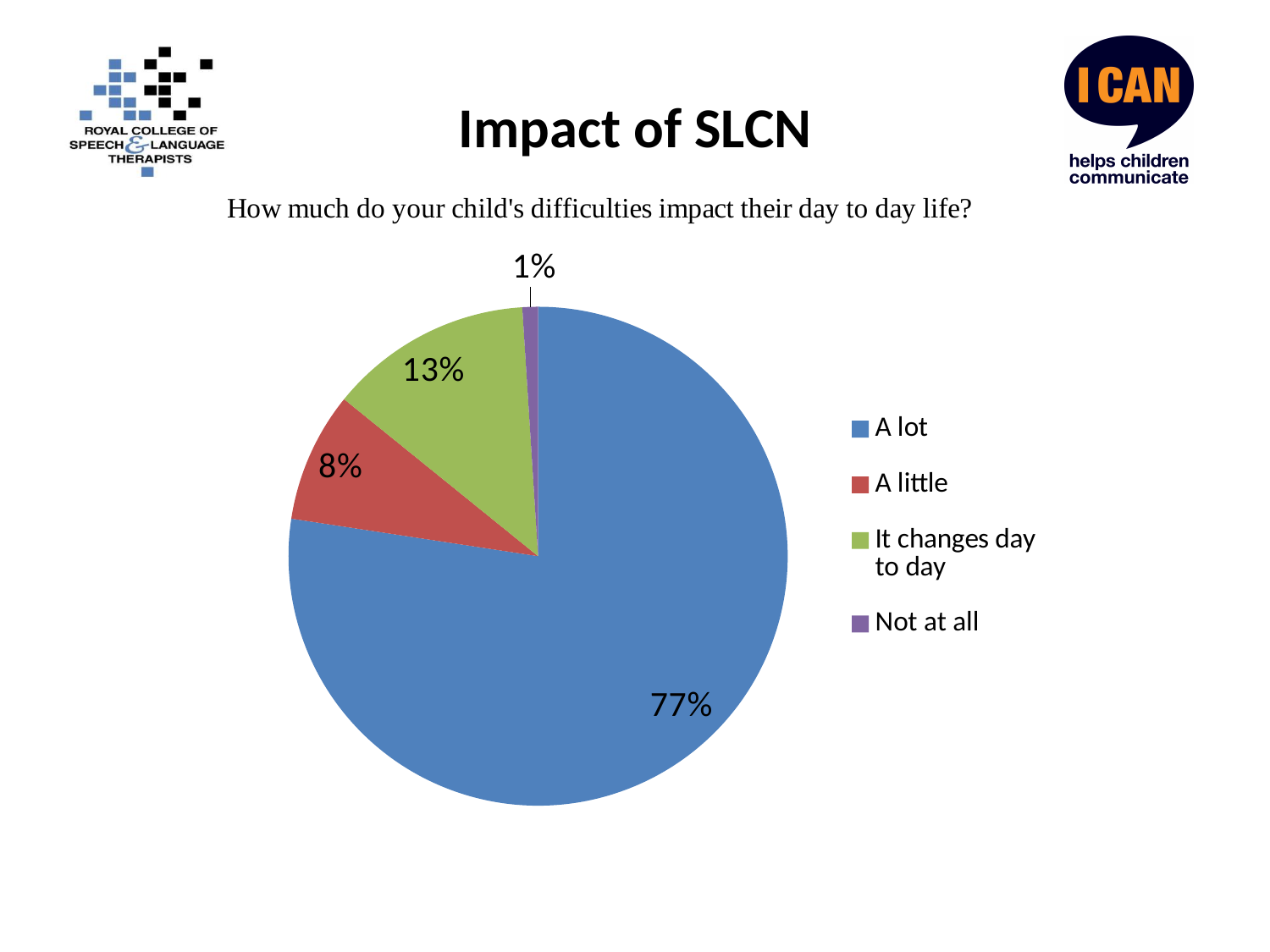
What colour is the slice for "A lot"? blue What is the difference in percentage points between "A lot" and "It changes day to day"? 64 What percentage of respondents answered "It changes day to day"? 13% What type of chart is shown on the slide? pie chart Which response has the smallest share of the pie? Not at all Which response has the largest share of the pie? A lot How many categories does the pie chart show? 4 What percentage of respondents answered "A little"? 8% What percentage of respondents answered "Not at all"? 1% What percentage of respondents answered "A lot"? 77% What is the difference in percentage points between "It changes day to day" and "A little"? 5 Which is larger, the share for "A little" or the share for "It changes day to day"? It changes day to day